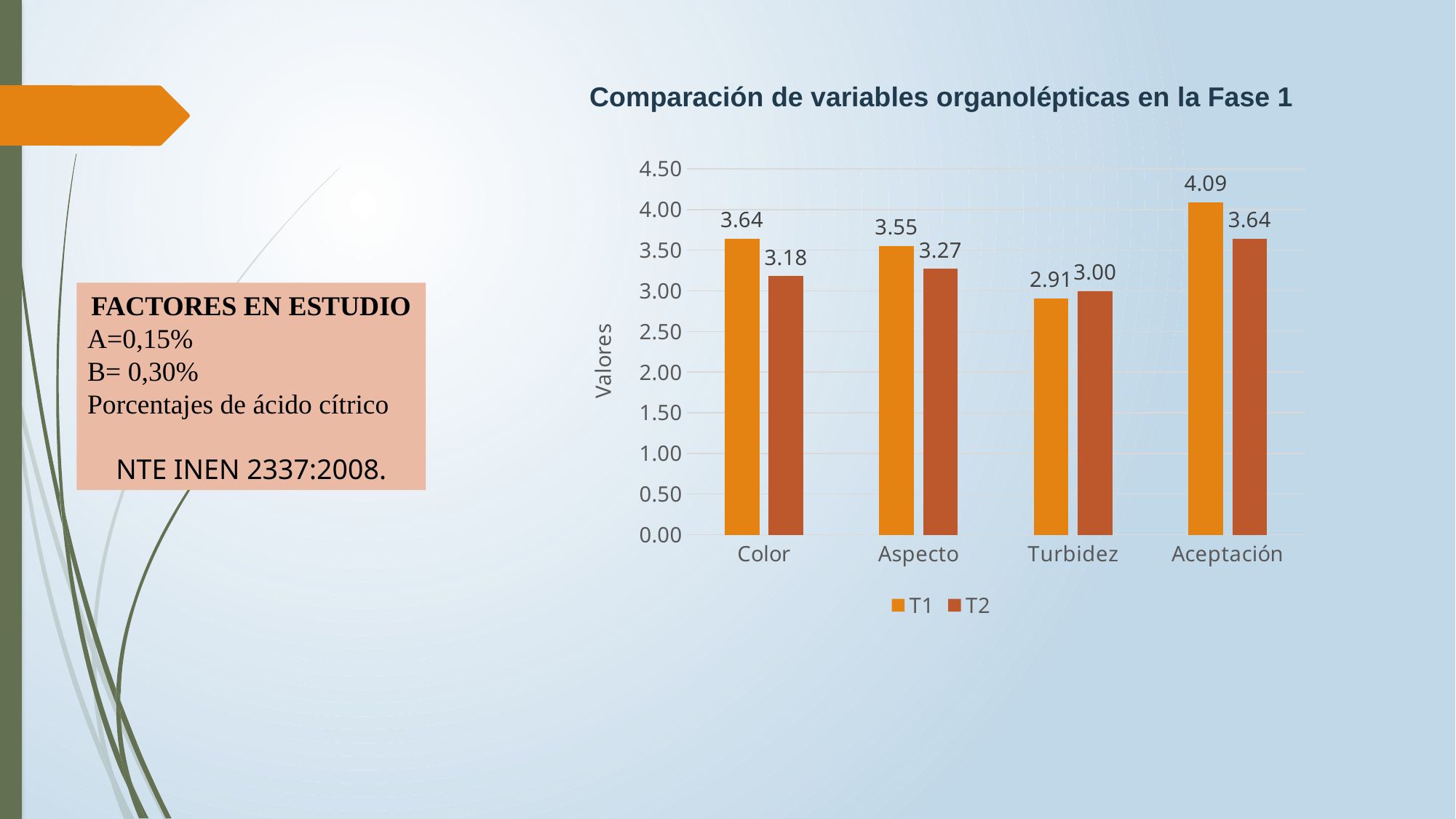
How many series does the legend list? 2 What is the difference between the T1 and T2 values for Aceptación? 0.45 How many categories are shown on the x axis? 4 What is the T2 value for Aspecto? 3.27 Is the T1 value for Aceptación greater or less than 4.00? greater Which is larger for Turbidez, T1 or T2? T2 Which category has the highest T1 value? Aceptación Which category has the lowest T2 value? Turbidez What is the T1 value for Color? 3.64 What is the title of the chart? Comparación de variables organolépticas en la Fase 1 What is the T2 value for Turbidez? 3.00 What kind of chart is shown? bar chart